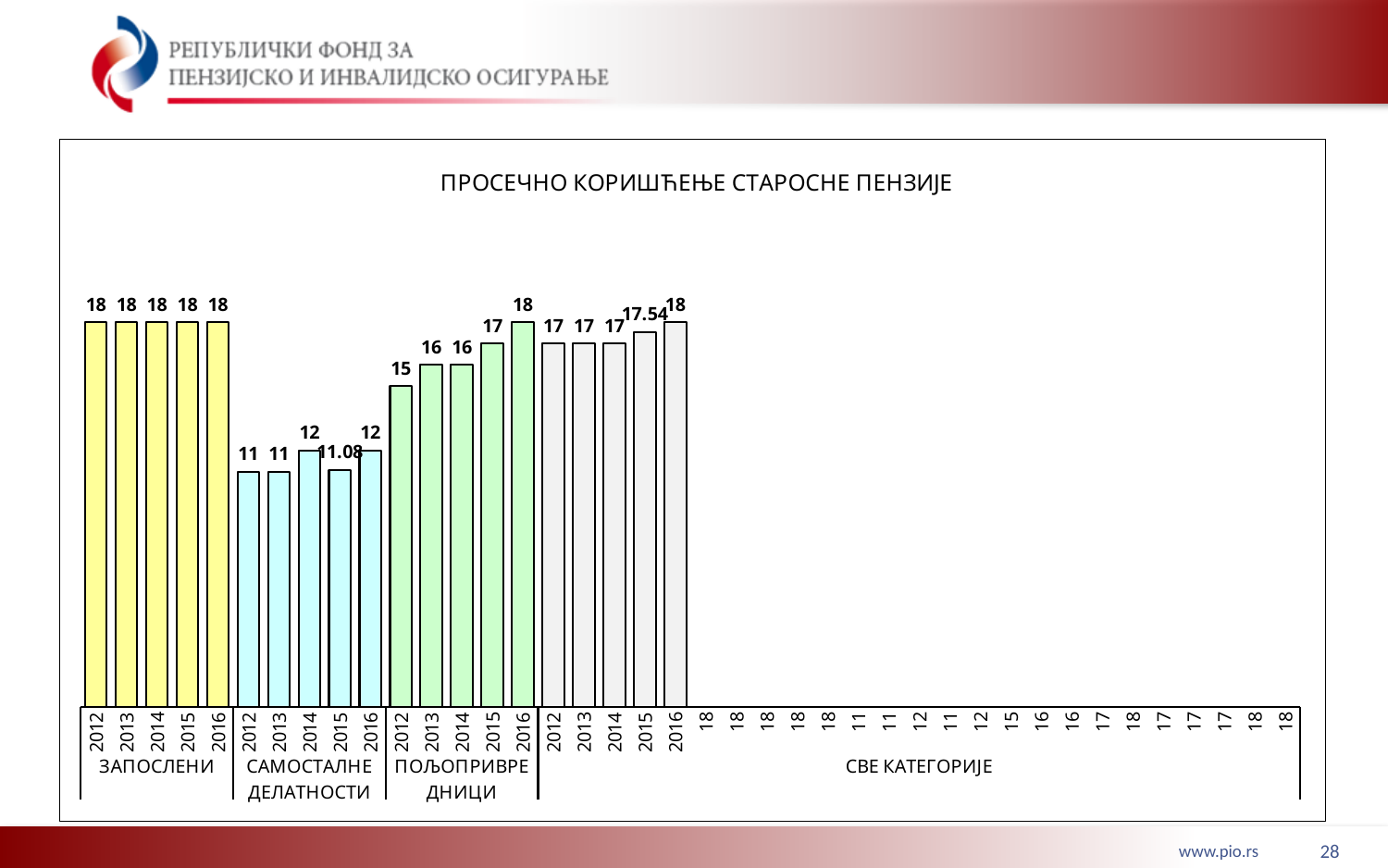
What is the value for ЗАПОСЛЕНИ in 2014? 18 What is the value for ПОЉОПРИВРЕДНИЦИ in 2016? 18 What is the title of the chart? ПРОСЕЧНО КОРИШЋЕЊЕ СТАРОСНЕ ПЕНЗИЈЕ How many years are shown for the ЗАПОСЛЕНИ group? 5 What type of chart is shown on the slide? bar chart What is the value for СВЕ КАТЕГОРИЈЕ in 2015? 17.54 What is the value for САМОСТАЛНЕ ДЕЛАТНОСТИ in 2015? 11.08 What is the value for ПОЉОПРИВРЕДНИЦИ in 2012? 15 Which year has the lowest value within the ПОЉОПРИВРЕДНИЦИ group? 2012 Which is larger: the value for ЗАПОСЛЕНИ in 2012 or the value for САМОСТАЛНЕ ДЕЛАТНОСТИ in 2012? ЗАПОСЛЕНИ in 2012 What is the difference between the ПОЉОПРИВРЕДНИЦИ value in 2016 and in 2012? 3 Do the values for ПОЉОПРИВРЕДНИЦИ rise or fall from 2012 to 2016? rise